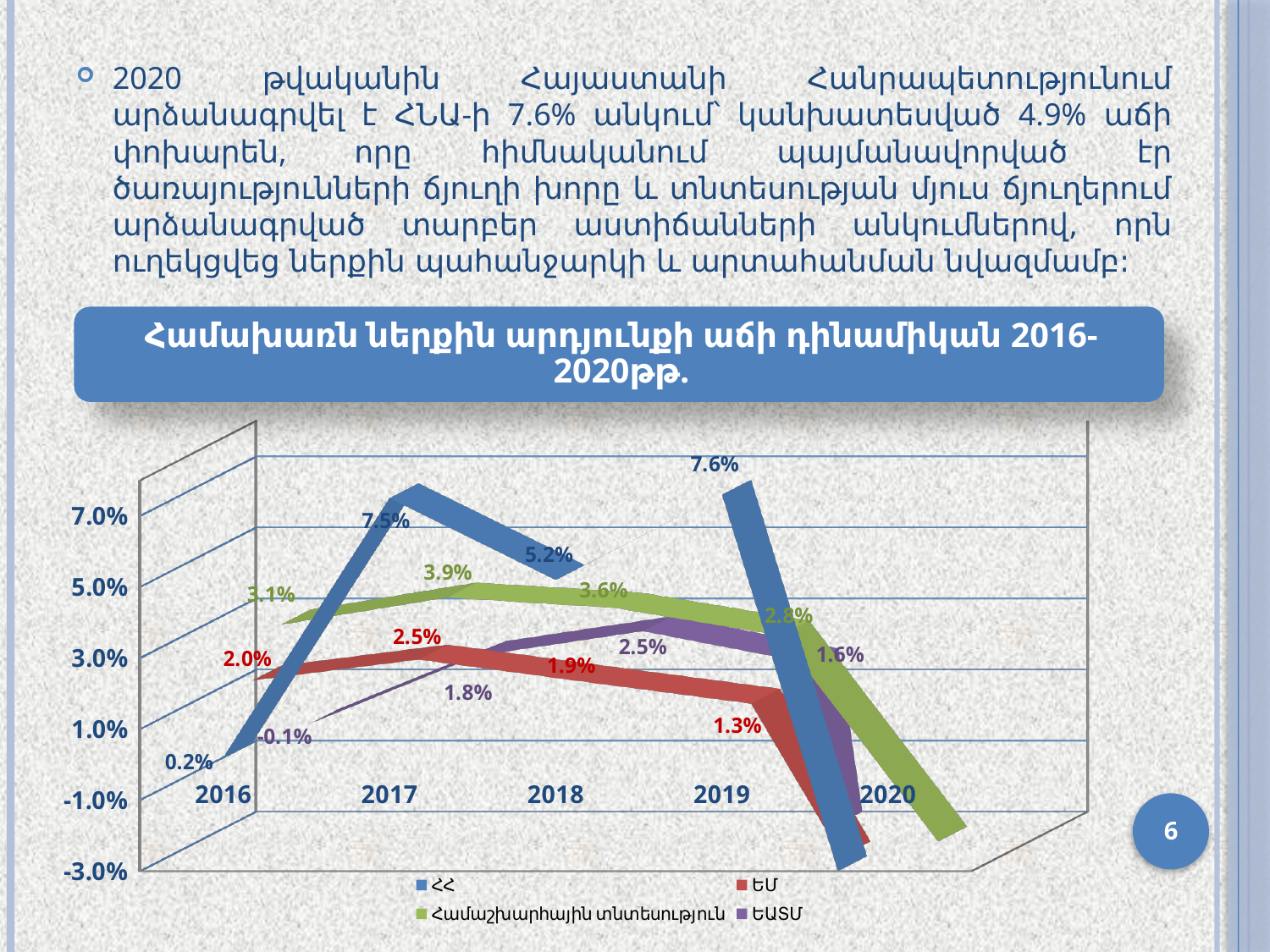
What is the value for ՀՀ in 2017? 7.5% What is the difference between the ՀՀ values for 2017 and 2018? 2.3 percentage points What type of chart is shown on the slide? Line chart Is the value for ՀՀ in 2020 greater or less than -1.0%? less In 2016, which is larger: the value for ԵՄ or for Համաշխարհային տնտեսություն? Համաշխարհային տնտեսություն What is the value for ԵԱՏՄ in 2016? -0.1% What is the value for Համաշխարհային տնտեսություն in 2017? 3.9% How many series does the chart legend list? 4 How many years are shown on the x axis of the chart? 5 What is the value for ԵՄ in 2017? 2.5% What is the value for ՀՀ in 2019? 7.6% In which year is the ՀՀ series at its lowest labelled value? 2016